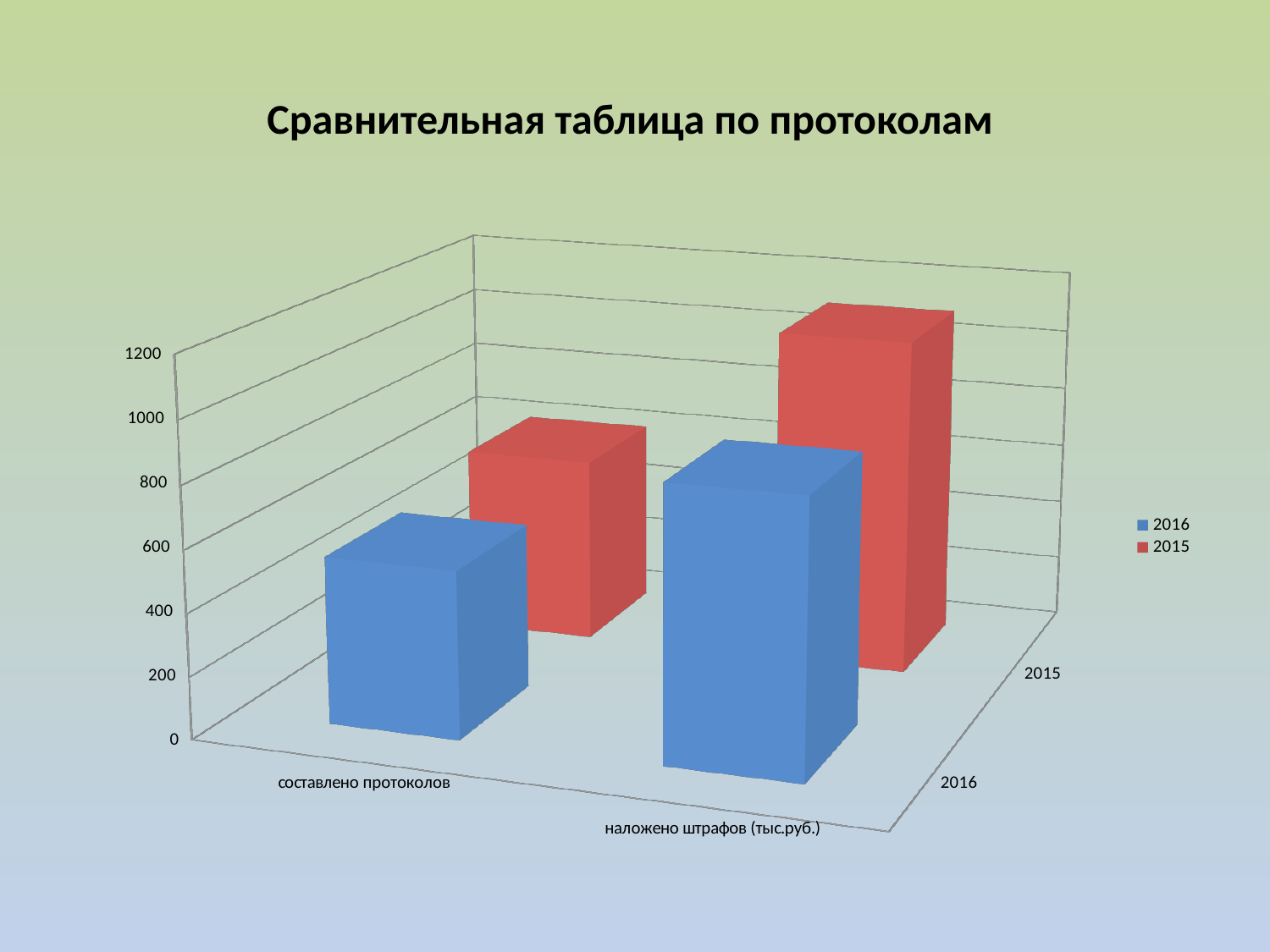
Is the 2015 value for 'наложено штрафов (тыс.руб.)' greater or less than 800? greater Is the 2015 value for 'составлено протоколов' greater or less than 1000? less How many series does the legend list? 2 Which colour represents the 2015 series in the legend? red Is the 2016 value for 'наложено штрафов (тыс.руб.)' greater or less than 600? greater What kind of chart is shown on the slide? bar chart How many categories are shown on the x axis? 2 Which category has the highest value for the 2016 series? наложено штрафов (тыс.руб.) Which category has the lowest value for the 2015 series? составлено протоколов What is the title of the chart? Сравнительная таблица по протоколам For 'наложено штрафов (тыс.руб.)', which series has the larger value, 2015 or 2016? 2015